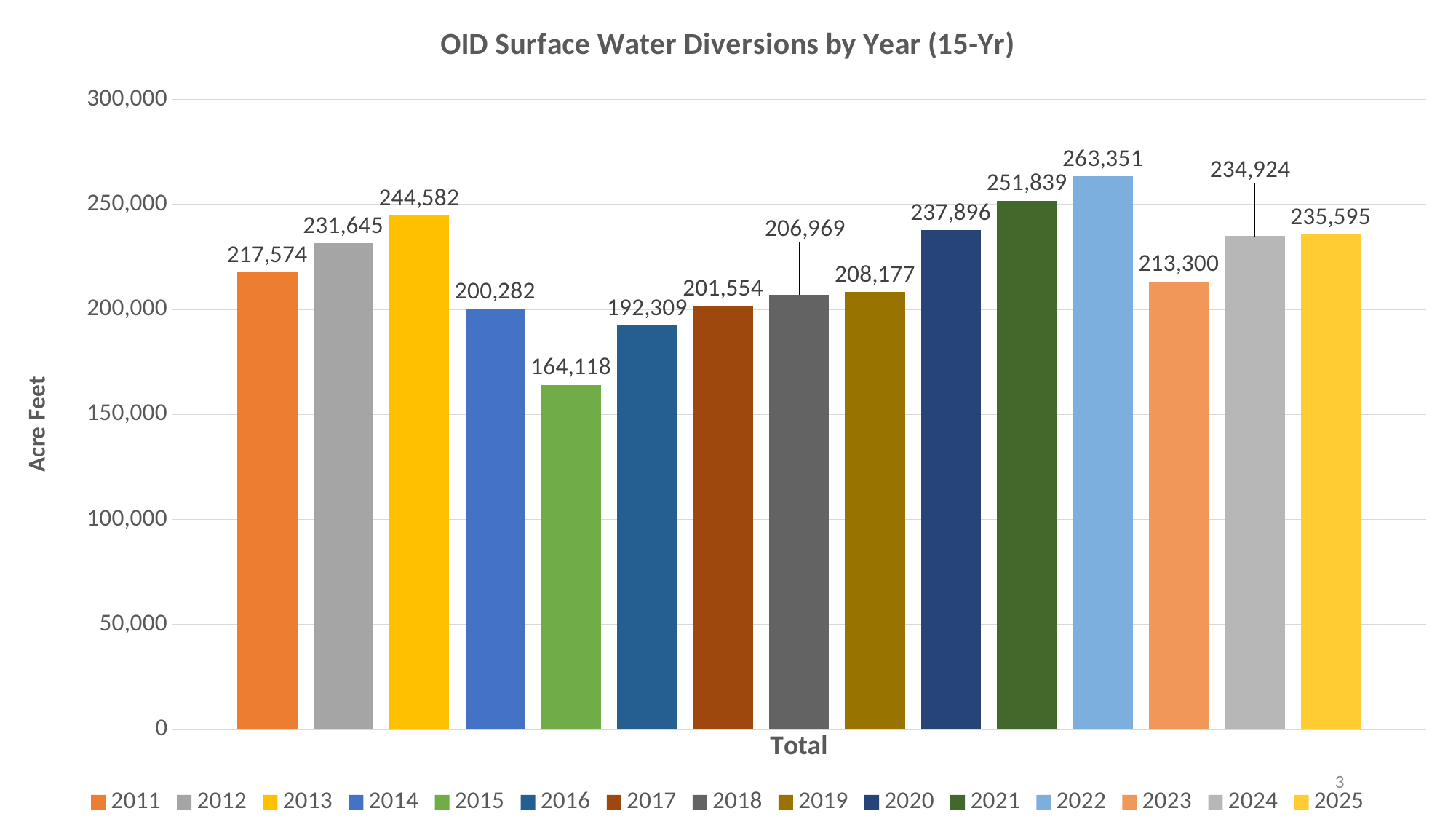
How many series does the legend list? 15 What is the value for 2022 in the OID Surface Water Diversions by Year chart? 263,351 Which year has the lowest surface water diversion in the chart? 2015 What is the value for 2018 in the chart? 206,969 How many bars are plotted in the chart? 15 What type of chart is shown on the slide? Bar chart What is the value for 2025 in the chart? 235,595 Which year has the highest surface water diversion in the chart? 2022 What is the difference between the values for 2013 and 2012? 12,937 What is the difference between the values for 2022 and 2015? 99,233 What is the value for 2015 in the chart? 164,118 Which is larger, the value for 2021 or the value for 2020? 2021